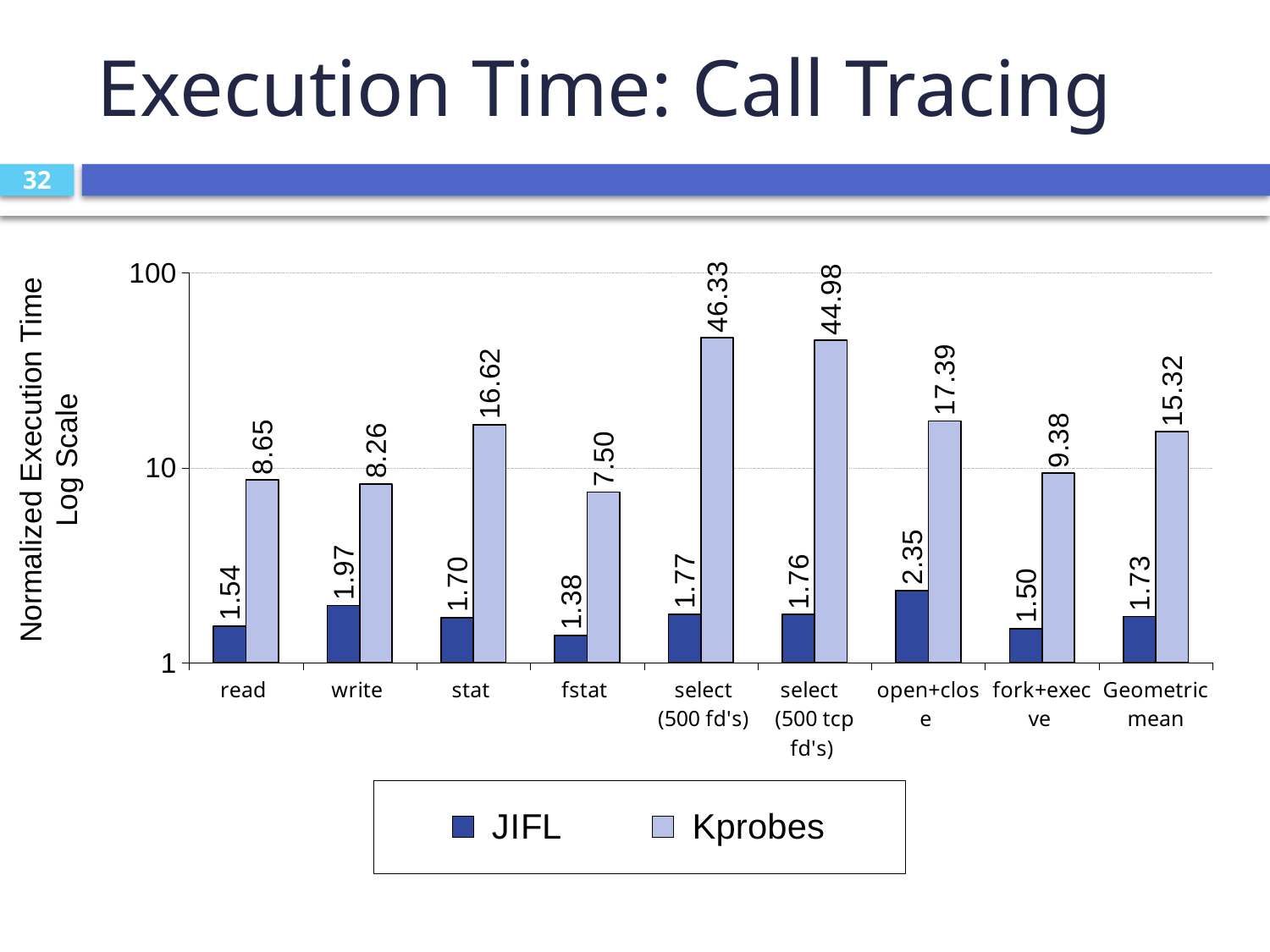
Which category has the lowest JIFL value? fstat How many series does the legend list? 2 What is the Kprobes value for select (500 fd's)? 46.33 What is the difference between the Kprobes and JIFL values for stat? 14.92 How many categories are shown on the x axis? 9 What is the JIFL value for read? 1.54 What is the Kprobes value for Geometric mean? 15.32 Is the Kprobes value for open+close greater or less than 10? greater Which is larger, the Kprobes value for read or the Kprobes value for write? read Which category has the highest Kprobes value? select (500 fd's) What is the y-axis label of the chart? Normalized Execution Time Log Scale What kind of chart is shown on the slide? bar chart